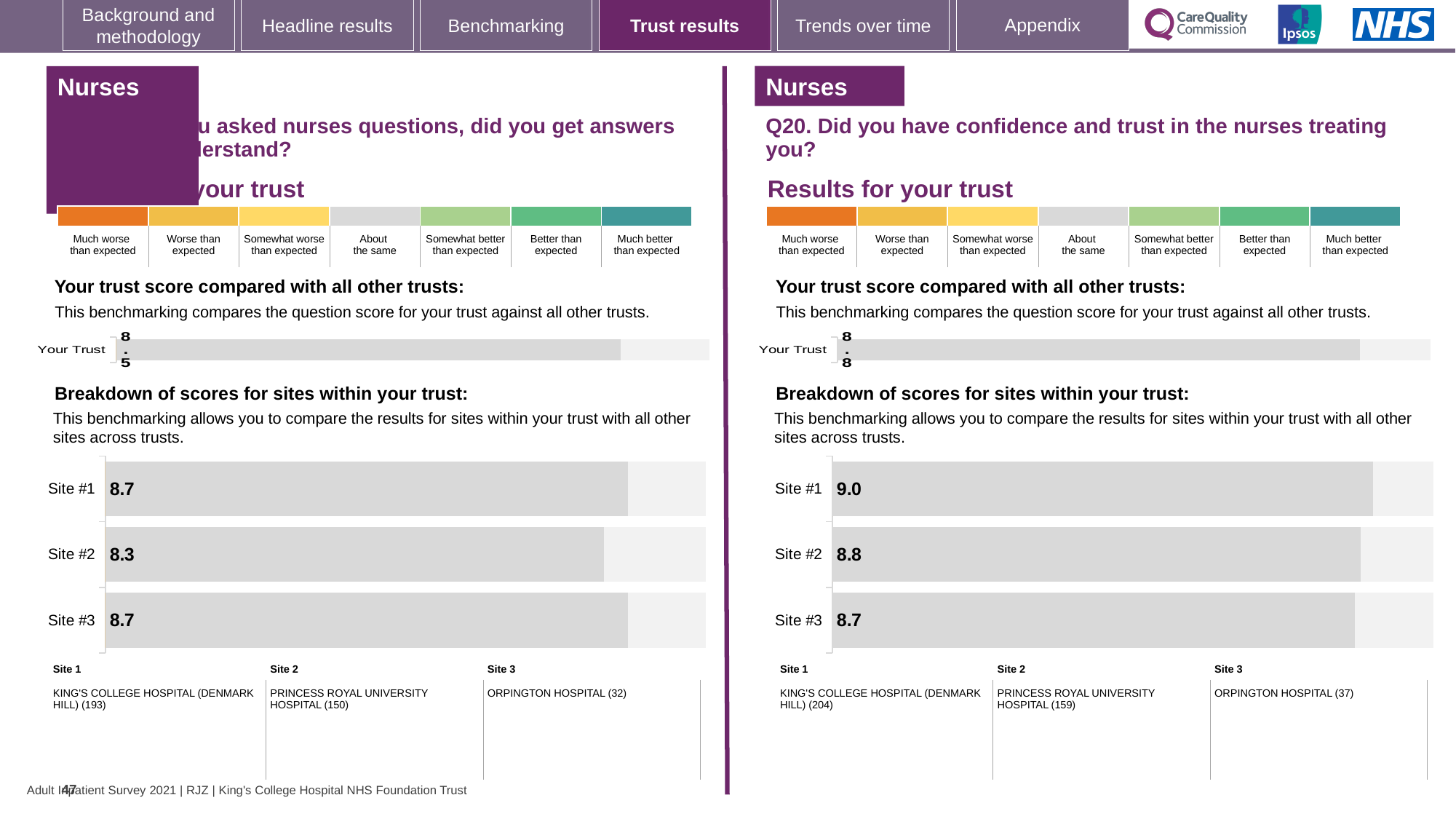
In the right-hand (Q20) site breakdown chart, what is the score for Site #1? 9.0 In the left-hand site breakdown chart, which site has the lowest score? Site #2 In the right-hand (Q20) site breakdown chart, which site has the highest score? Site #1 In the right-hand (Q20) site breakdown chart, which site has the lowest score? Site #3 In the right-hand (Q20) site breakdown chart, what is the difference between the scores for Site #1 and Site #3? 0.3 In the left-hand site breakdown chart, what is the difference between the scores for Site #1 and Site #2? 0.4 How many sites are shown in the left-hand site breakdown chart? 3 In the right-hand (Q20) 'Your trust score compared with all other trusts' chart, what is the score for Your Trust? 8.8 In the left-hand 'Your trust score compared with all other trusts' chart, what is the score for Your Trust? 8.5 In the right-hand (Q20) site breakdown chart, what is the score for Site #3? 8.7 What type of chart is used for the site breakdown on the right-hand (Q20) side of the slide? Bar chart In the left-hand site breakdown chart, what is the score for Site #2? 8.3